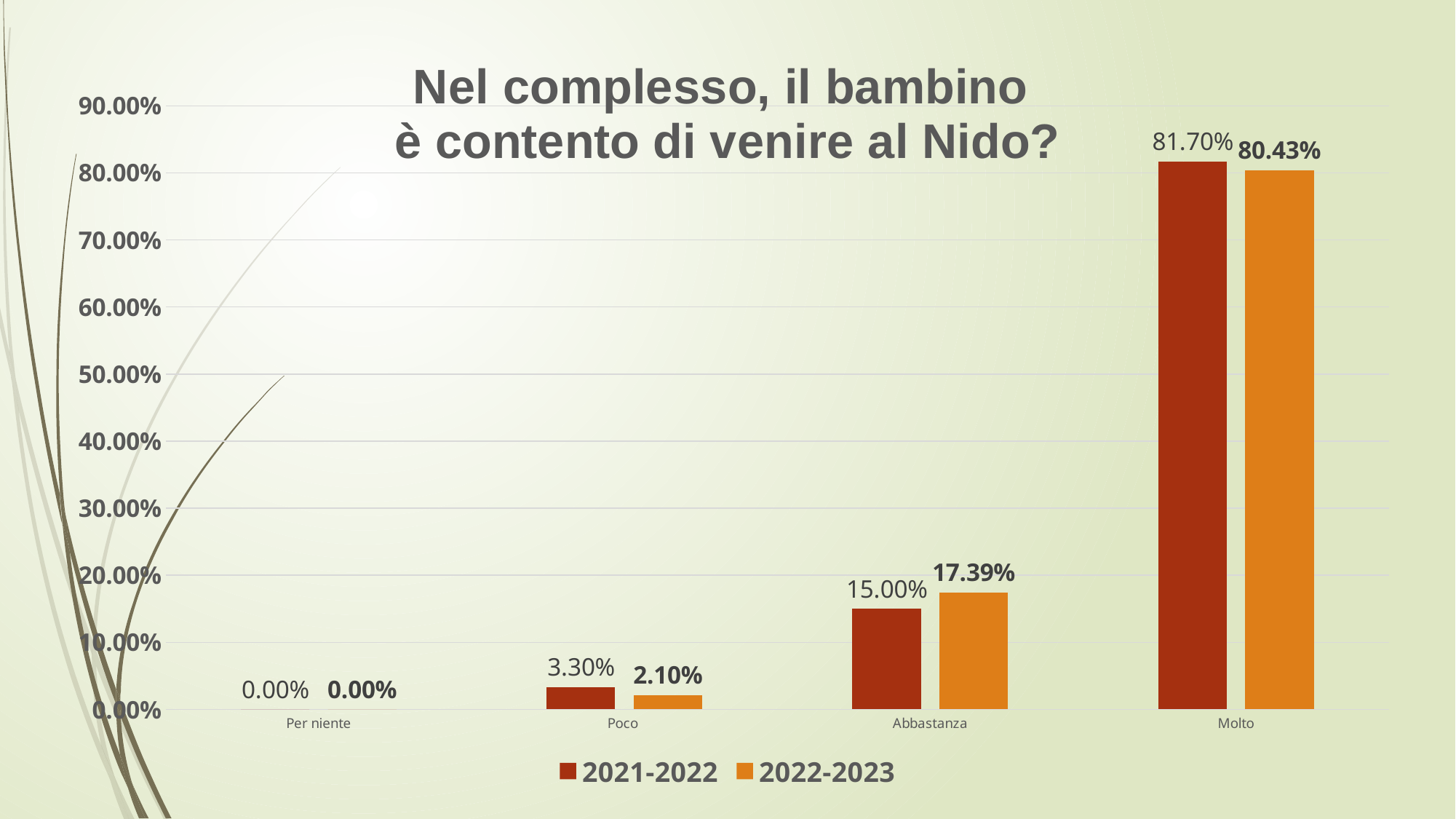
What is the value for Poco in the 2021-2022 series? 3.30% What is the value for Per niente in the 2022-2023 series? 0.00% Which category has the lowest value in the 2021-2022 series? Per niente What kind of chart is shown on the slide? bar chart What is the value for Molto in the 2021-2022 series? 81.70% What is the value for Abbastanza in the 2022-2023 series? 17.39% How many series does the legend list? 2 Which is larger for Poco: the 2021-2022 value or the 2022-2023 value? 2021-2022 What is the difference between the 2021-2022 and 2022-2023 values for Abbastanza? 2.39% Is the 2022-2023 value for Molto greater or less than 70.00%? greater Which category has the highest value in the 2022-2023 series? Molto How many categories are shown on the x axis? 4